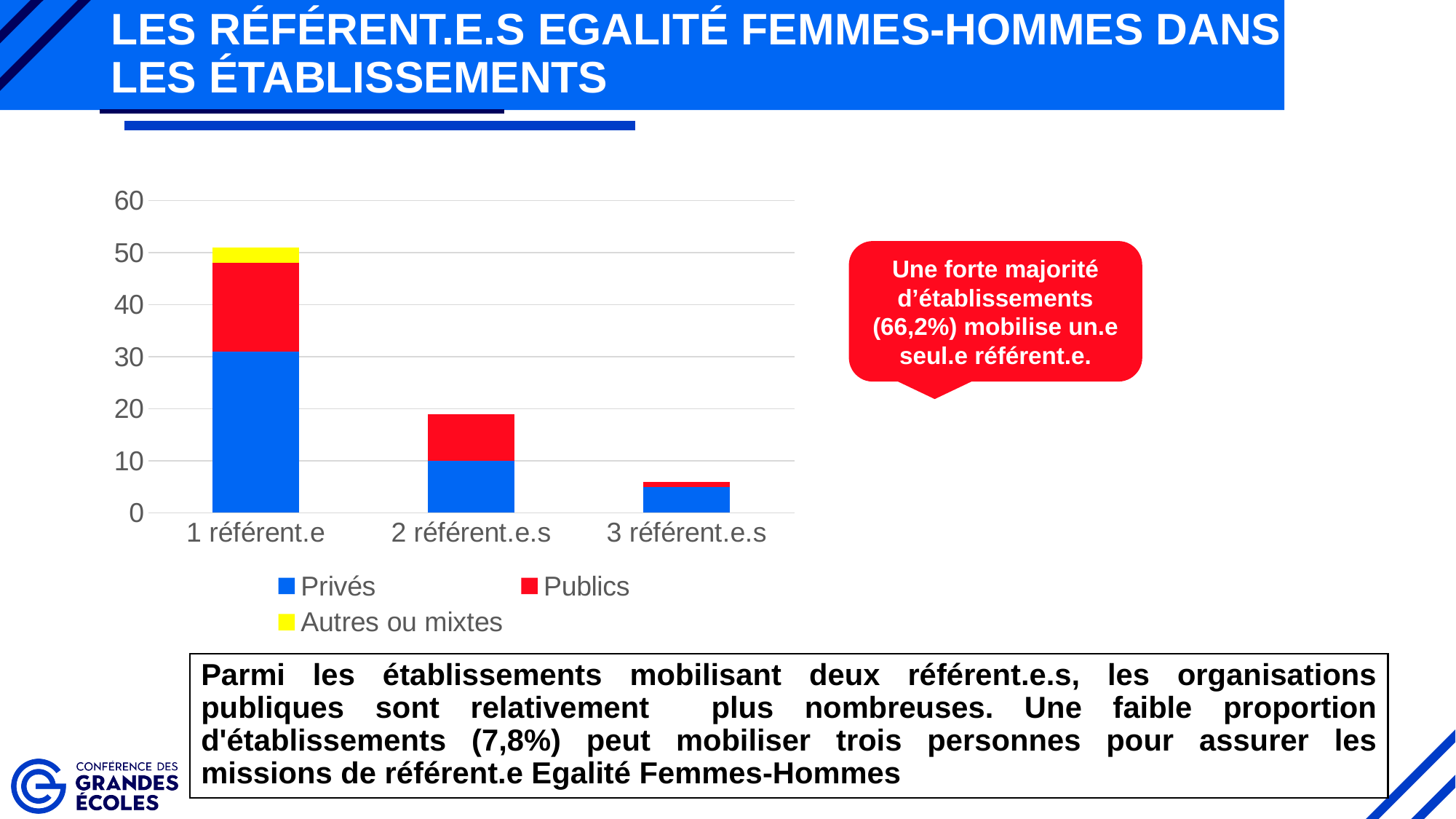
Is the total of the stacked bar for 1 référent.e greater or less than 40? greater Is the Privés value for 1 référent.e greater or less than 20? greater Which stacked bar is taller, 1 référent.e or 2 référent.e.s? 1 référent.e How many categories are shown on the x axis of the chart? 3 Which category has the tallest stacked bar? 1 référent.e Which category has the shortest stacked bar? 3 référent.e.s How many series does the chart legend list? 3 Do the stacked bar totals rise or fall from left to right along the x axis? fall Which series is shown in yellow in the chart legend? Autres ou mixtes Is the total of the stacked bar for 3 référent.e.s greater or less than 10? less What kind of chart is shown on the slide? stacked bar chart